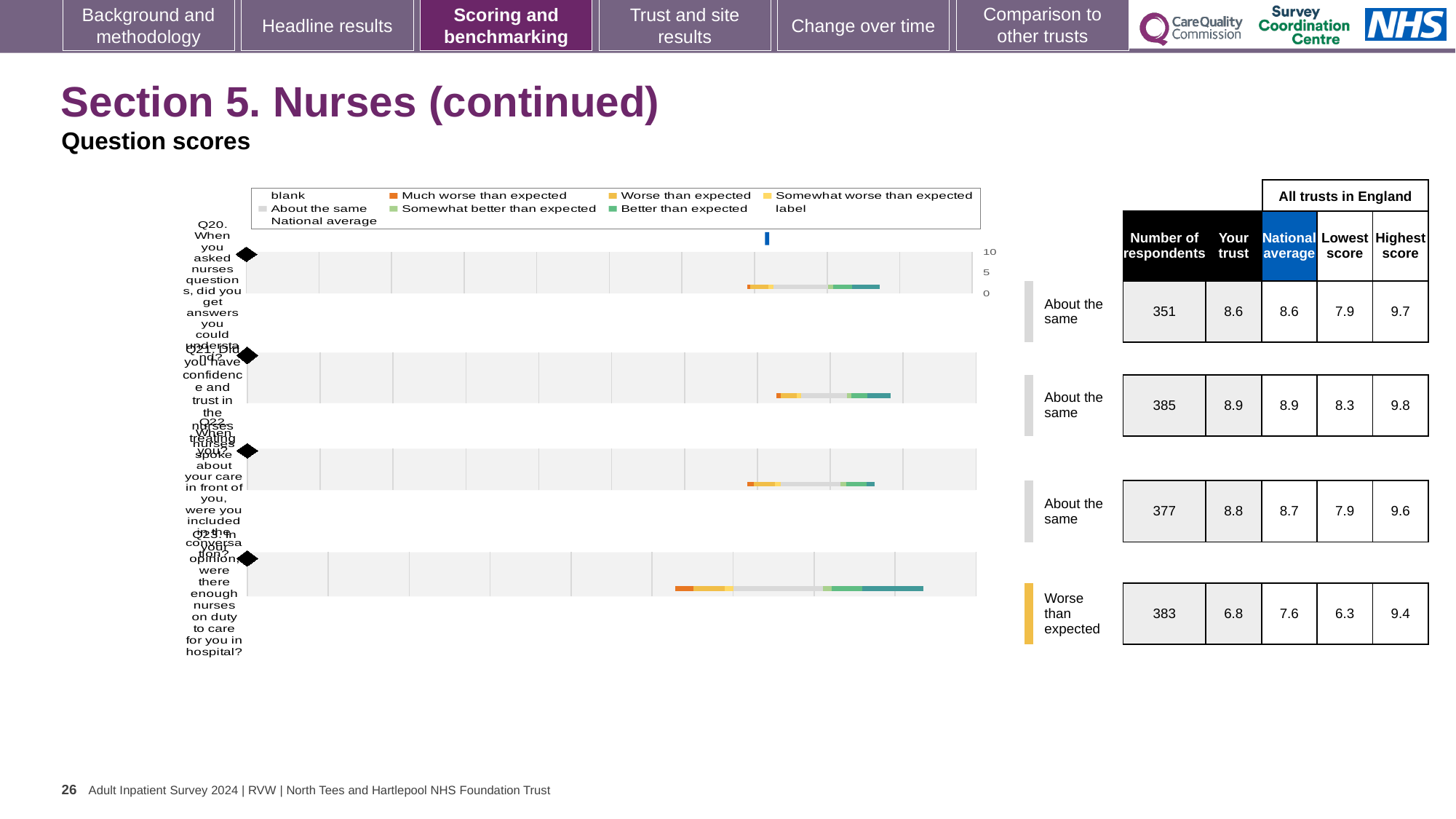
Which benchmark category is Q23 (enough nurses on duty) assigned to? Worse than expected What is the difference between the national average and the 'Your trust' score for Q23? 0.8 How many questions (bars) are plotted in the chart? 4 How many respondents answered Q21 (confidence and trust in the nurses)? 385 What is the highest value shown on the chart's x axis? 10 Which legend entry is shown in orange, representing the worst benchmark category? Much worse than expected What kind of chart is shown on the slide? bar chart Which question has the highest 'Your trust' score? Q21 What is the highest score among all trusts in England for Q20? 9.7 Which question has the lowest 'Your trust' score? Q23 What is the national average score for Q22 (included in the conversation)? 8.7 What is the 'Your trust' score for Q23 (enough nurses on duty)? 6.8